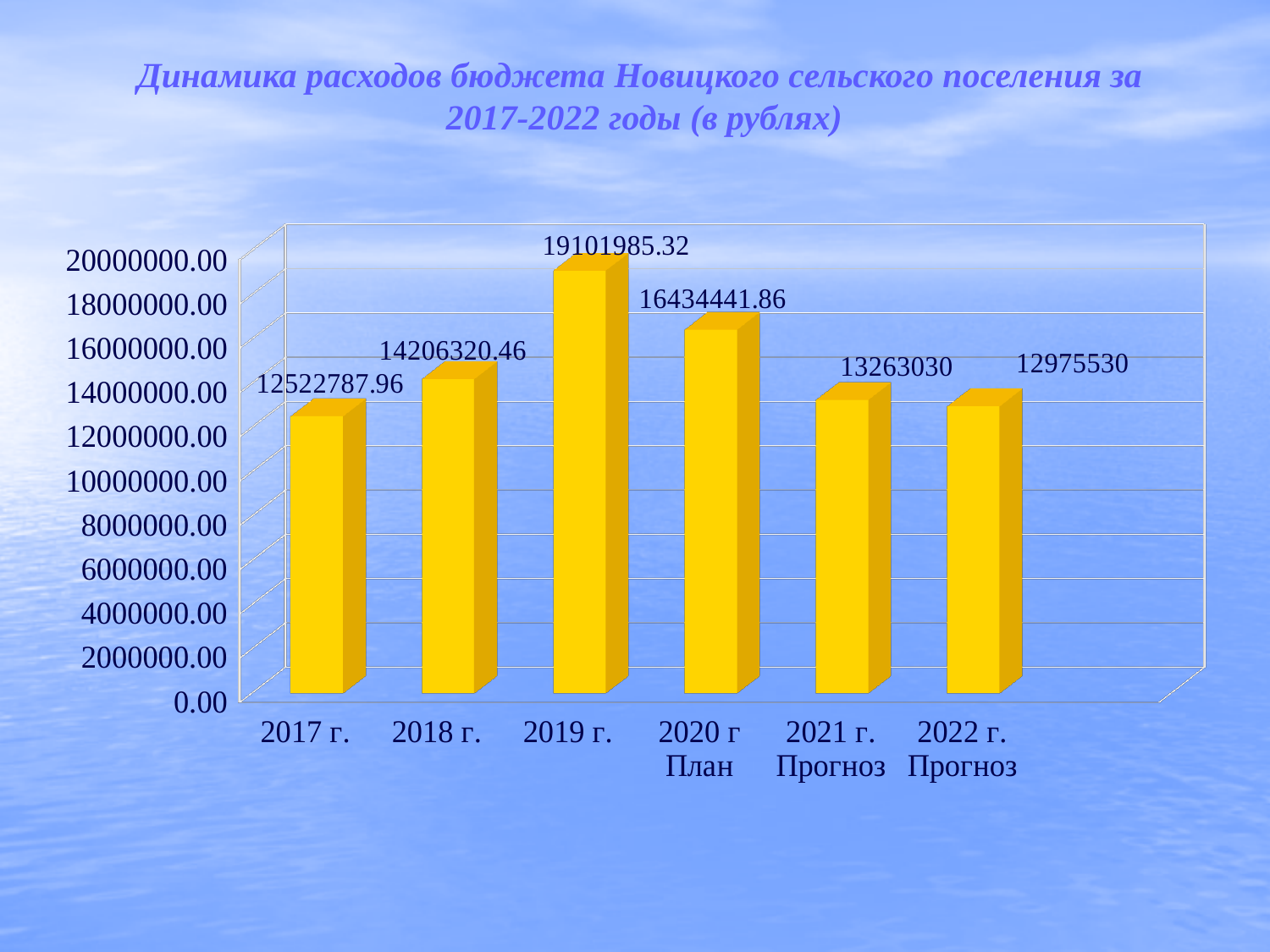
Is the value for 2017 г. greater or less than 14000000.00? less What value is shown for 2022 г. Прогноз? 12975530 Do the values rise or fall from 2019 г. to 2022 г. Прогноз? fall What is the budget expenditure value shown for 2019 г.? 19101985.32 Which year has the highest expenditure value? 2019 г. How many years (categories) are shown on the chart? 6 Which is larger, the value for 2021 г. Прогноз or 2022 г. Прогноз? 2021 г. Прогноз What type of chart is shown on the slide? bar chart Which year has the lowest expenditure value? 2017 г. What value is shown for 2020 г План? 16434441.86 What is the difference between the values for 2019 г. and 2018 г.? 4895664.86 What is the difference between the values for 2021 г. Прогноз and 2022 г. Прогноз? 287500